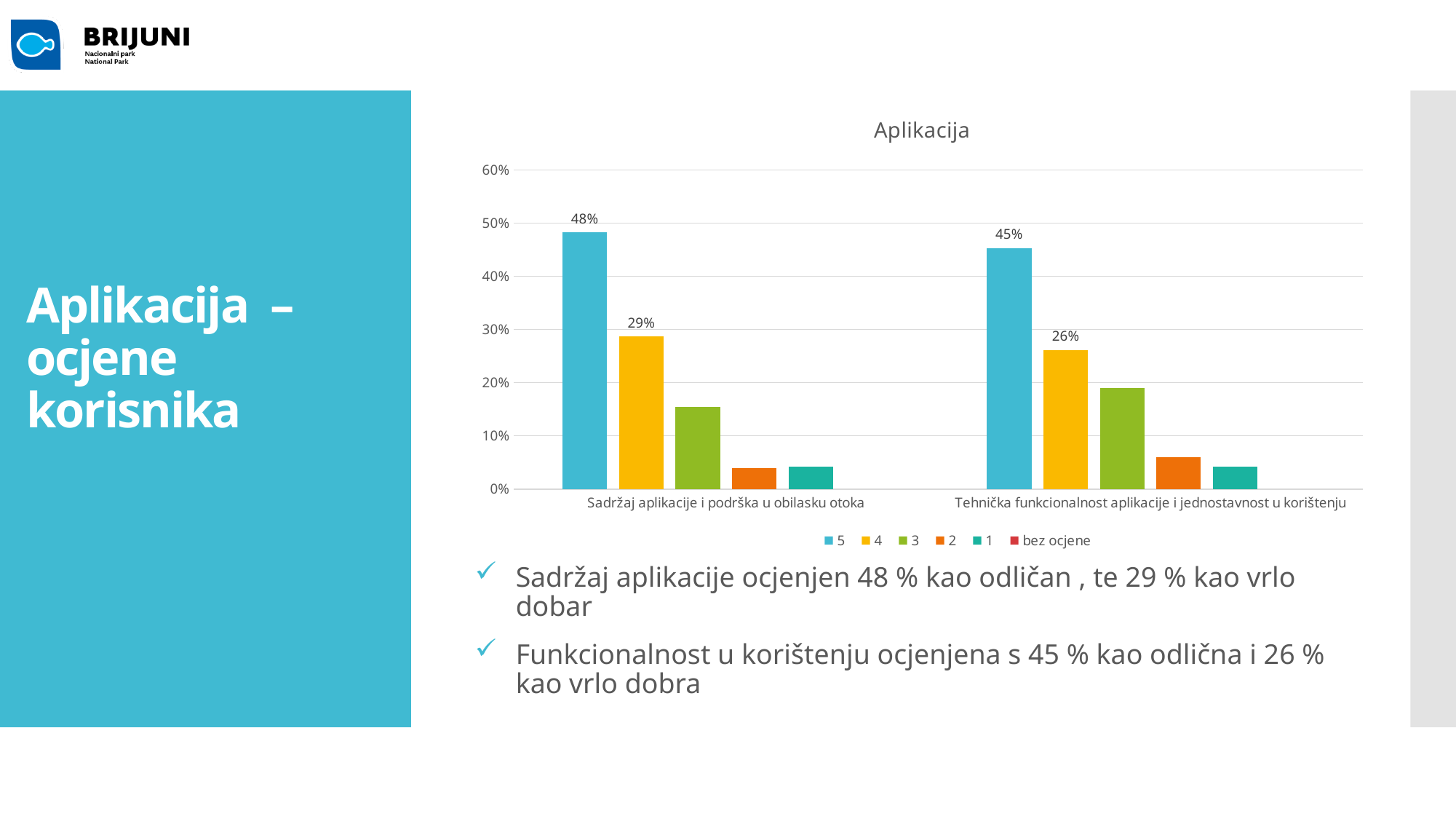
How many categories are shown on the x axis of the chart? 2 What is the value for rating 4 in the category "Sadržaj aplikacije i podrška u obilasku otoka"? 29% Which category has the larger value for rating 4: "Sadržaj aplikacije i podrška u obilasku otoka" or "Tehnička funkcionalnost aplikacije i jednostavnost u korištenju"? Sadržaj aplikacije i podrška u obilasku otoka Is the value for rating 3 in "Tehnička funkcionalnost aplikacije i jednostavnost u korištenju" greater or less than 10%? greater What is the difference between the rating 5 values for "Sadržaj aplikacije i podrška u obilasku otoka" and "Tehnička funkcionalnost aplikacije i jednostavnost u korištenju"? 3 percentage points What is the value for rating 5 in the category "Tehnička funkcionalnost aplikacije i jednostavnost u korištenju"? 45% How many series does the chart legend list? 6 What is the value for rating 5 in the category "Sadržaj aplikacije i podrška u obilasku otoka"? 48% Which rating has the highest value in the category "Sadržaj aplikacije i podrška u obilasku otoka"? 5 What is the value for rating 4 in the category "Tehnička funkcionalnost aplikacije i jednostavnost u korištenju"? 26% What type of chart is shown on the slide? bar chart Is the value for rating 3 in "Sadržaj aplikacije i podrška u obilasku otoka" greater or less than 20%? less